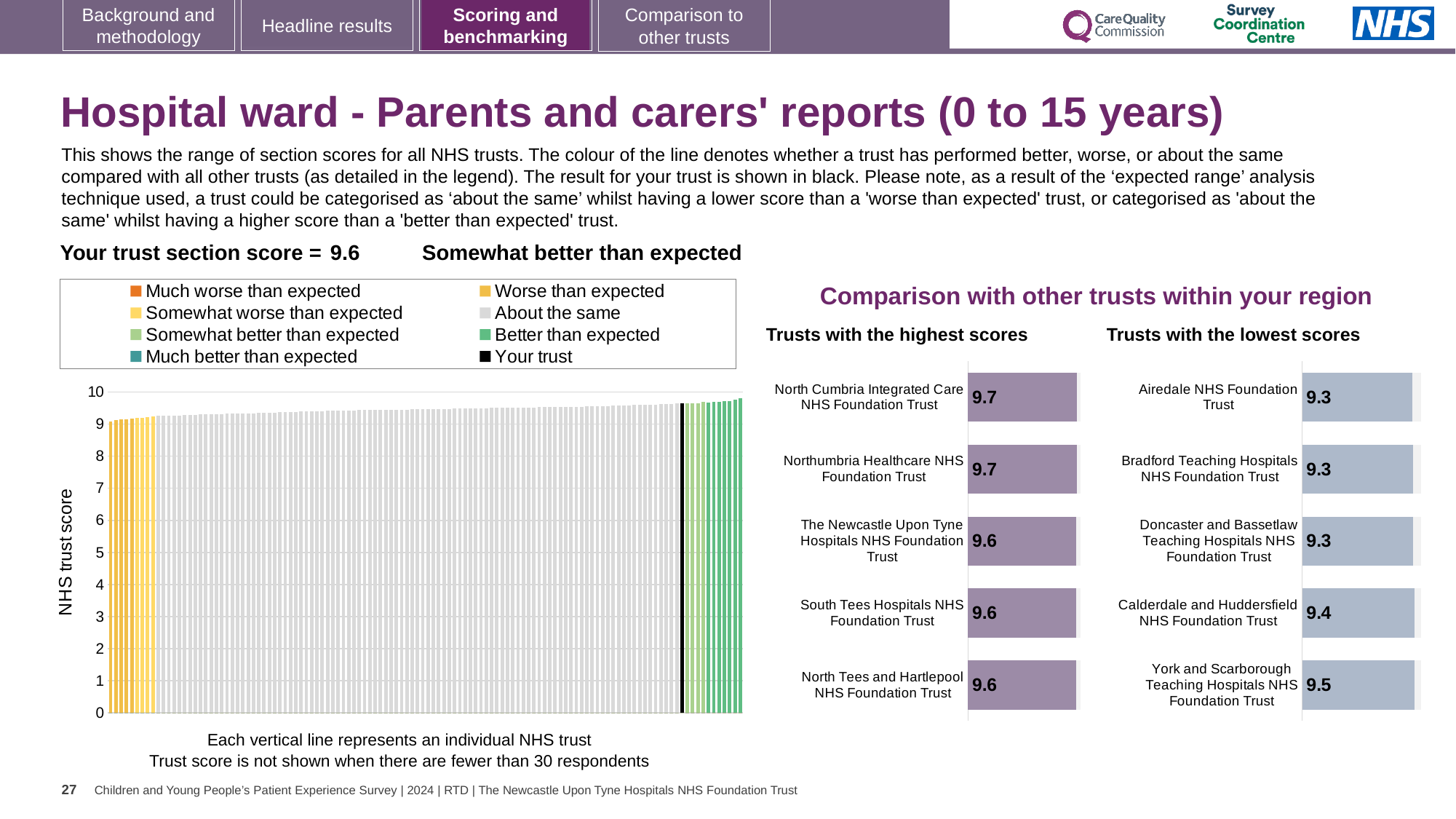
How many entries does the legend above the large chart on the left list? 8 In the large chart on the left, what is the label on the y axis? NHS trust score In the 'Trusts with the highest scores' chart, what is the value for South Tees Hospitals NHS Foundation Trust? 9.6 In the 'Trusts with the lowest scores' chart, which is larger: the value for Calderdale and Huddersfield NHS Foundation Trust or the value for Bradford Teaching Hospitals NHS Foundation Trust? Calderdale and Huddersfield NHS Foundation Trust In the 'Trusts with the lowest scores' chart, what is the value for Calderdale and Huddersfield NHS Foundation Trust? 9.4 What kind of chart is the large chart on the left with the y axis labelled 'NHS trust score'? bar chart How many trusts are shown in the 'Trusts with the highest scores' chart? 5 In the 'Trusts with the lowest scores' chart, which trust has the highest value? York and Scarborough Teaching Hospitals NHS Foundation Trust In the large chart on the left, is the value for the black 'Your trust' line greater or less than 9? greater In the 'Trusts with the highest scores' chart, what is the difference between the values for Northumbria Healthcare NHS Foundation Trust and The Newcastle Upon Tyne Hospitals NHS Foundation Trust? 0.1 In the 'Trusts with the lowest scores' chart, what is the difference between the values for York and Scarborough Teaching Hospitals NHS Foundation Trust and Airedale NHS Foundation Trust? 0.2 In the 'Trusts with the highest scores' chart, what is the value for North Cumbria Integrated Care NHS Foundation Trust? 9.7